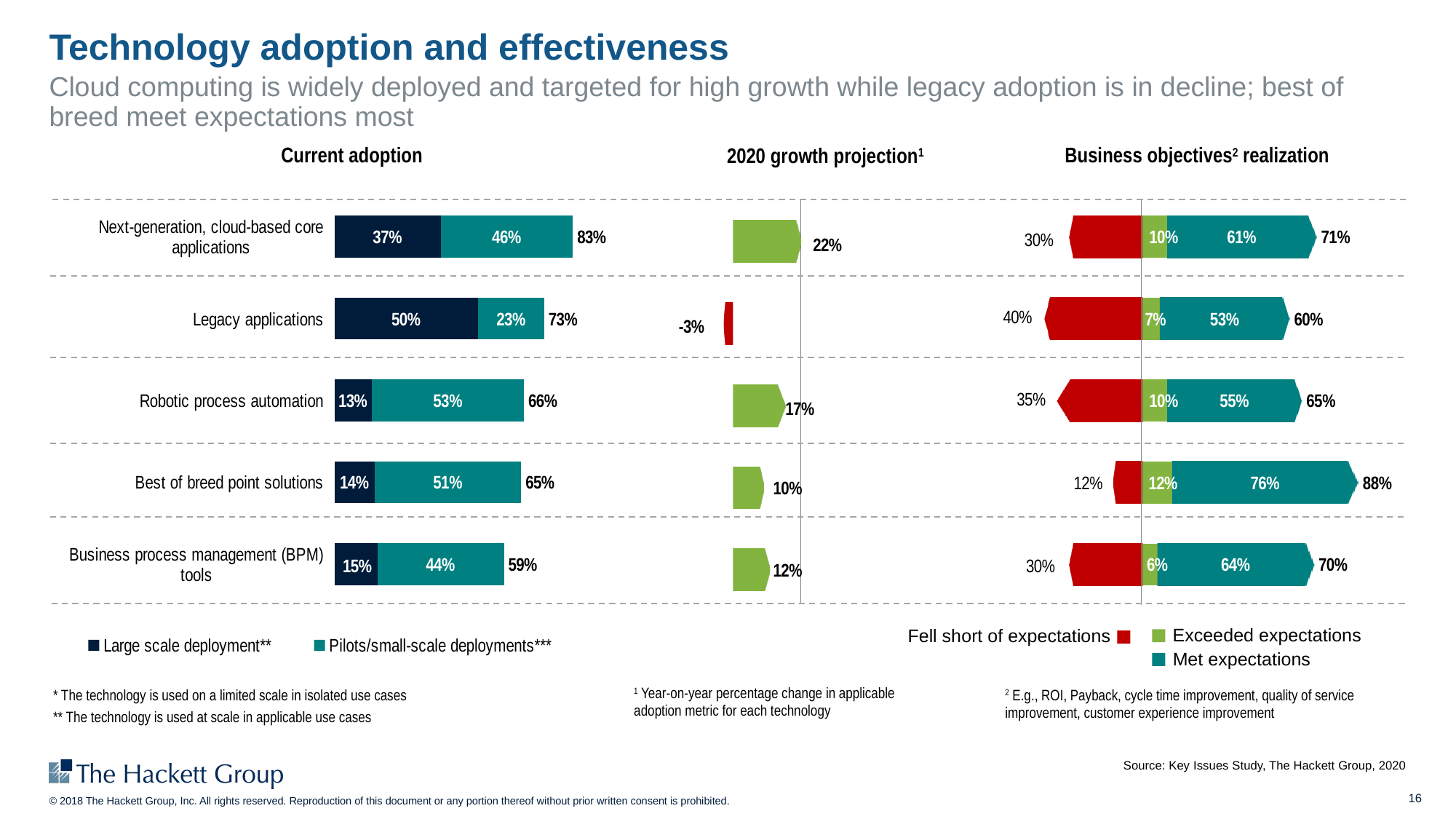
In the Current adoption chart, what is the large scale deployment value for Legacy applications? 50% How many technologies are shown in the Current adoption chart? 5 In the 2020 growth projection chart, which is larger: the value for Robotic process automation or the value for Business process management (BPM) tools? Robotic process automation In the Current adoption chart, what is the total adoption for Next-generation, cloud-based core applications? 83% How many series does the legend of the Business objectives realization chart list? 3 In the Business objectives realization chart, what percentage of Best of breed point solutions fell short of expectations? 12% In the Current adoption chart, what is the difference between the pilots/small-scale deployments values for Robotic process automation and Best of breed point solutions? 2% In the Business objectives realization chart, which technology has the highest combined met and exceeded expectations value? Best of breed point solutions In the 2020 growth projection chart, which technology has the highest growth projection? Next-generation, cloud-based core applications In the 2020 growth projection chart, what is the value for Legacy applications? -3% In the Current adoption chart, which technology has the lowest total adoption? Business process management (BPM) tools In the Business objectives realization chart, what is the met expectations value for Legacy applications? 53%